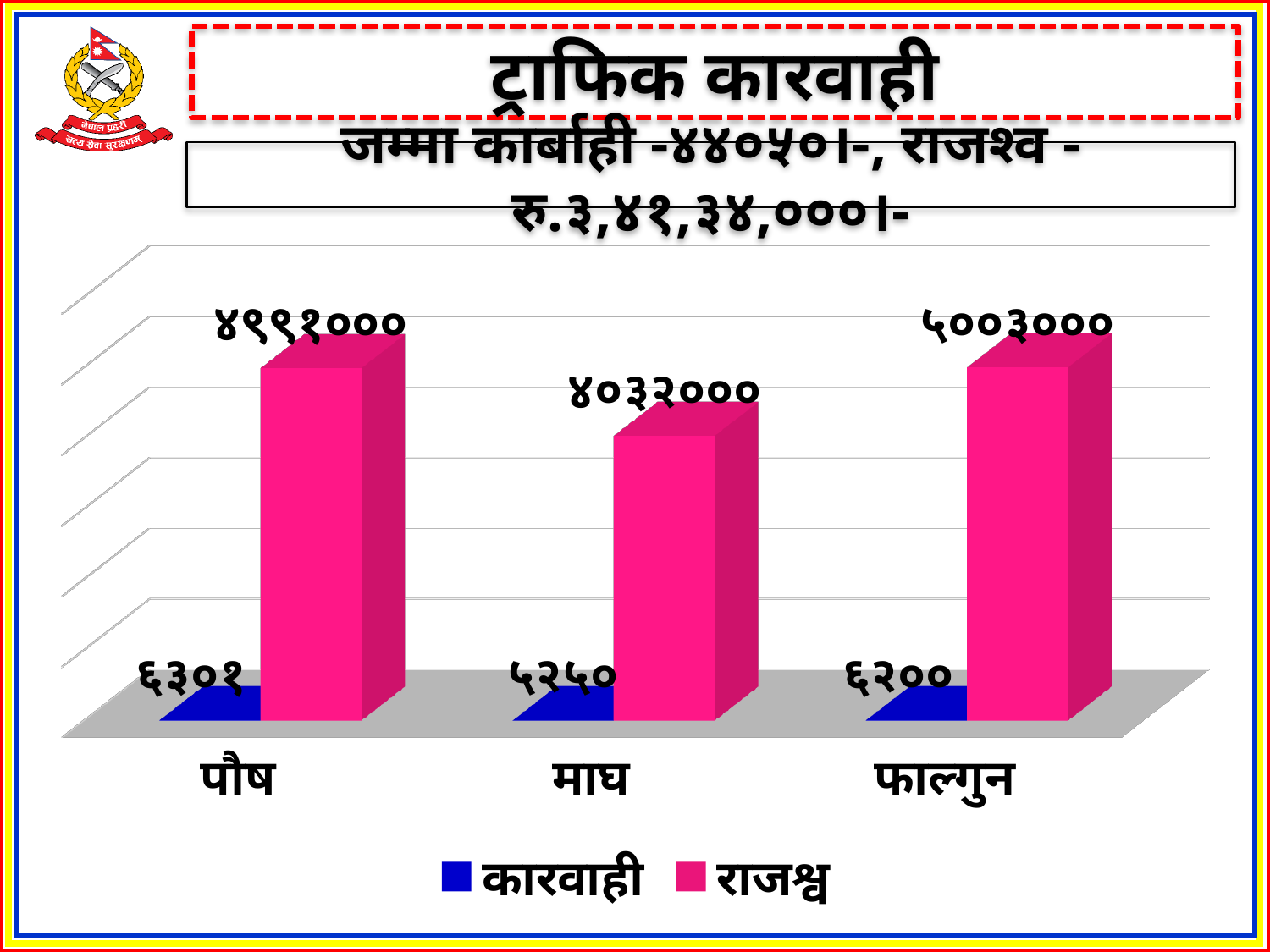
What type of chart is shown on the slide? bar chart What is the कारवाही value for माघ? ५२५० How many categories (months) are shown on the x axis of the chart? 3 What is the कारवाही value for फाल्गुन? ६२०० Which series is shown in pink in the chart legend? राजश्व Which month has the highest राजश्व value? फाल्गुन Which month has the lowest कारवाही value? माघ How many series does the chart legend list? 2 Which is larger, the राजश्व value for पौष or for माघ? पौष What is the राजश्व value for पौष? ४९९१००० What is the difference between the कारवाही values for पौष and माघ? १०५१ What is the राजश्व value for फाल्गुन? ५००३०००